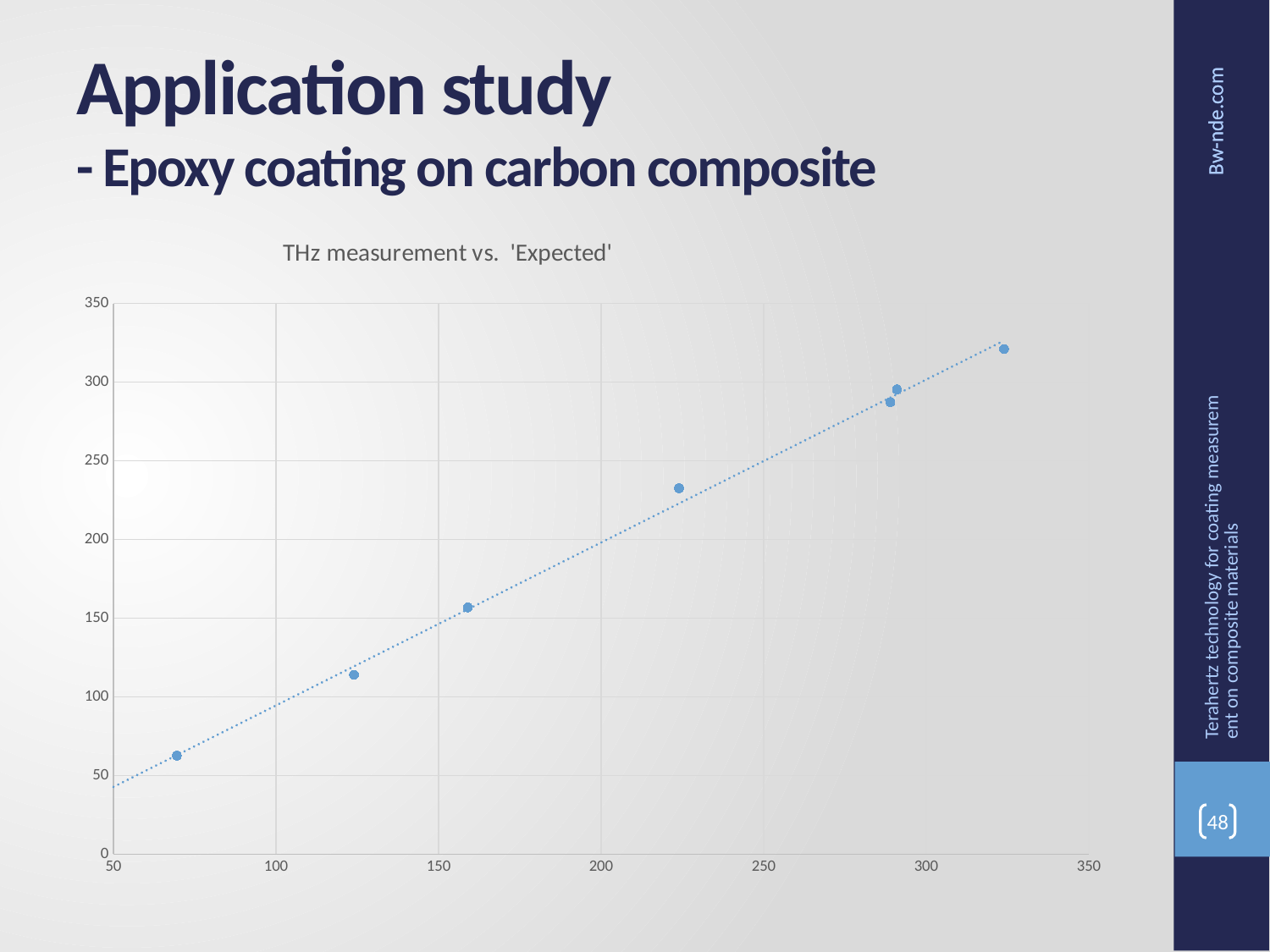
Do the plotted values rise or fall as the x-axis value increases? rise What is the minimum value shown on the x-axis? 50 Is the y value of the point at about x = 325 greater or less than 300? greater Is the y value of the point at about x = 70 greater or less than 100? less Is the y value of the point at about x = 225 greater or less than 200? greater What is the maximum value shown on the y-axis? 350 Which point has the highest y value: the one at about x = 70 or the one at about x = 325? the one at about x = 325 What kind of chart is shown on the slide? scatter chart What is the title of the chart? THz measurement vs. 'Expected' How many data points are plotted on the chart? 7